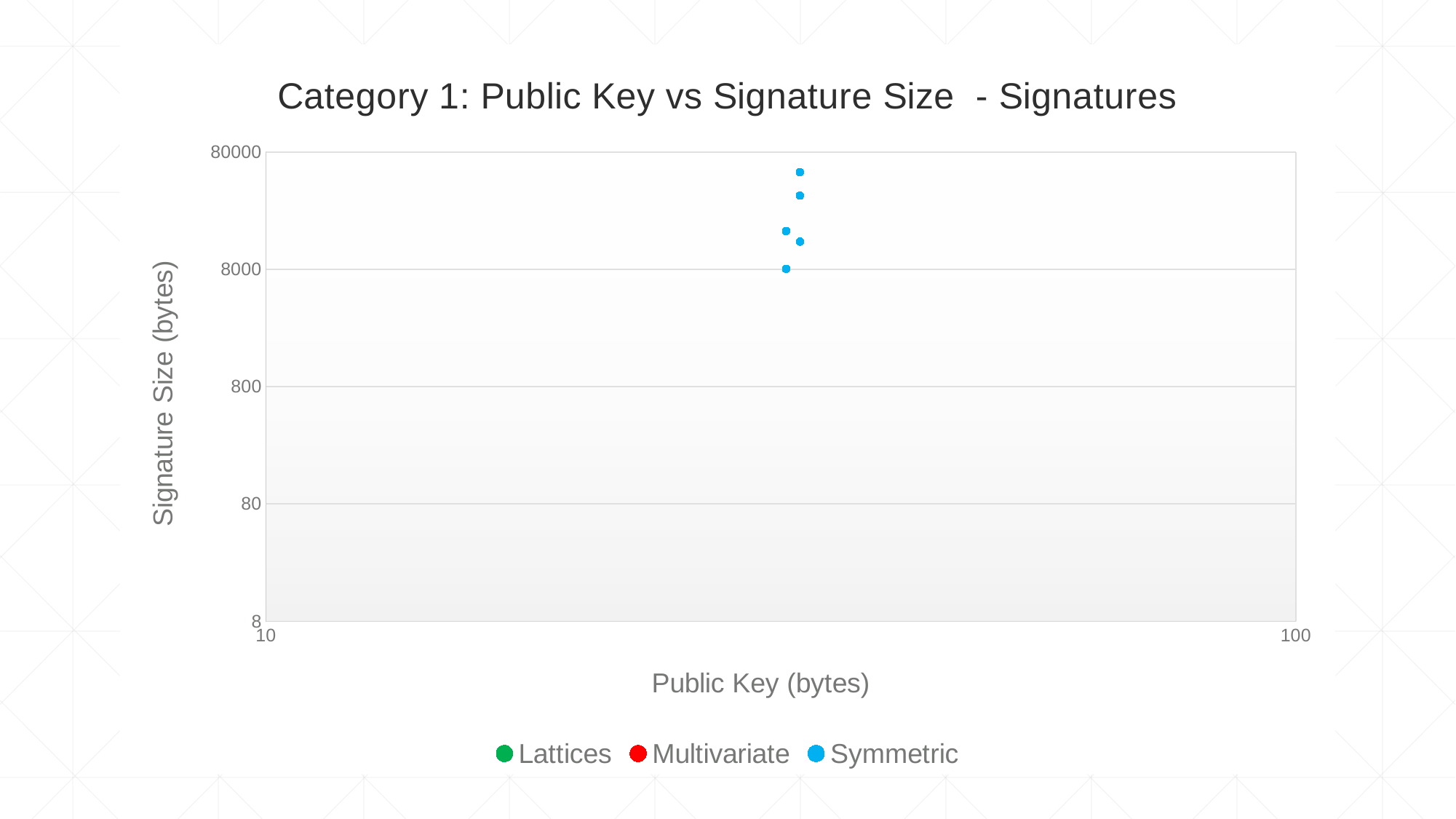
Are the public key sizes of the plotted points greater or less than 10 bytes? greater How many series does the legend list? 3 What kind of chart is shown on the slide? Scatter chart Which series do the plotted points belong to? Symmetric What is the title of the chart? Category 1: Public Key vs Signature Size - Signatures Is the signature size of the highest plotted point greater or less than 8000 bytes? greater How many data points are plotted on the chart? 5 Is the signature size of the highest plotted point greater or less than 80000 bytes? less